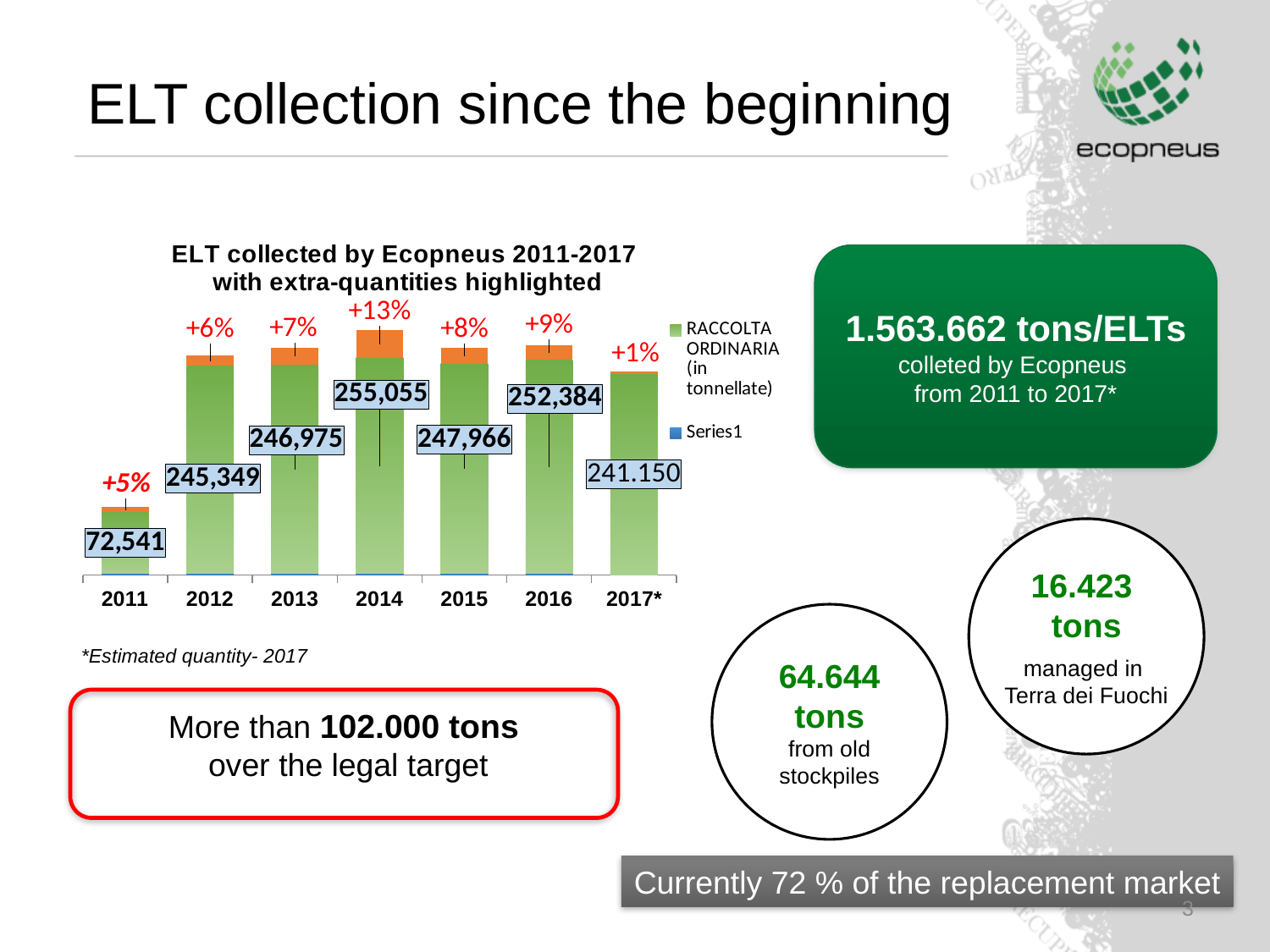
Which year has the larger labelled value, 2015 or 2016? 2016 What value is labelled on the bar for 2017*? 241.150 Which year has the lowest labelled value? 2011 How many years are shown on the x axis of the chart? 7 Which year shows the smallest percentage increase above its bar? 2017* What is the difference between the labelled values for 2014 and 2013? 8,080 What percentage is shown above the 2014 bar? +13% What type of chart is used to show ELT collected by Ecopneus 2011-2017? Bar chart How many series does the chart legend list? 2 What value is labelled on the bar for 2011? 72,541 Which year has the highest labelled value? 2014 What value is labelled on the bar for 2014? 255,055